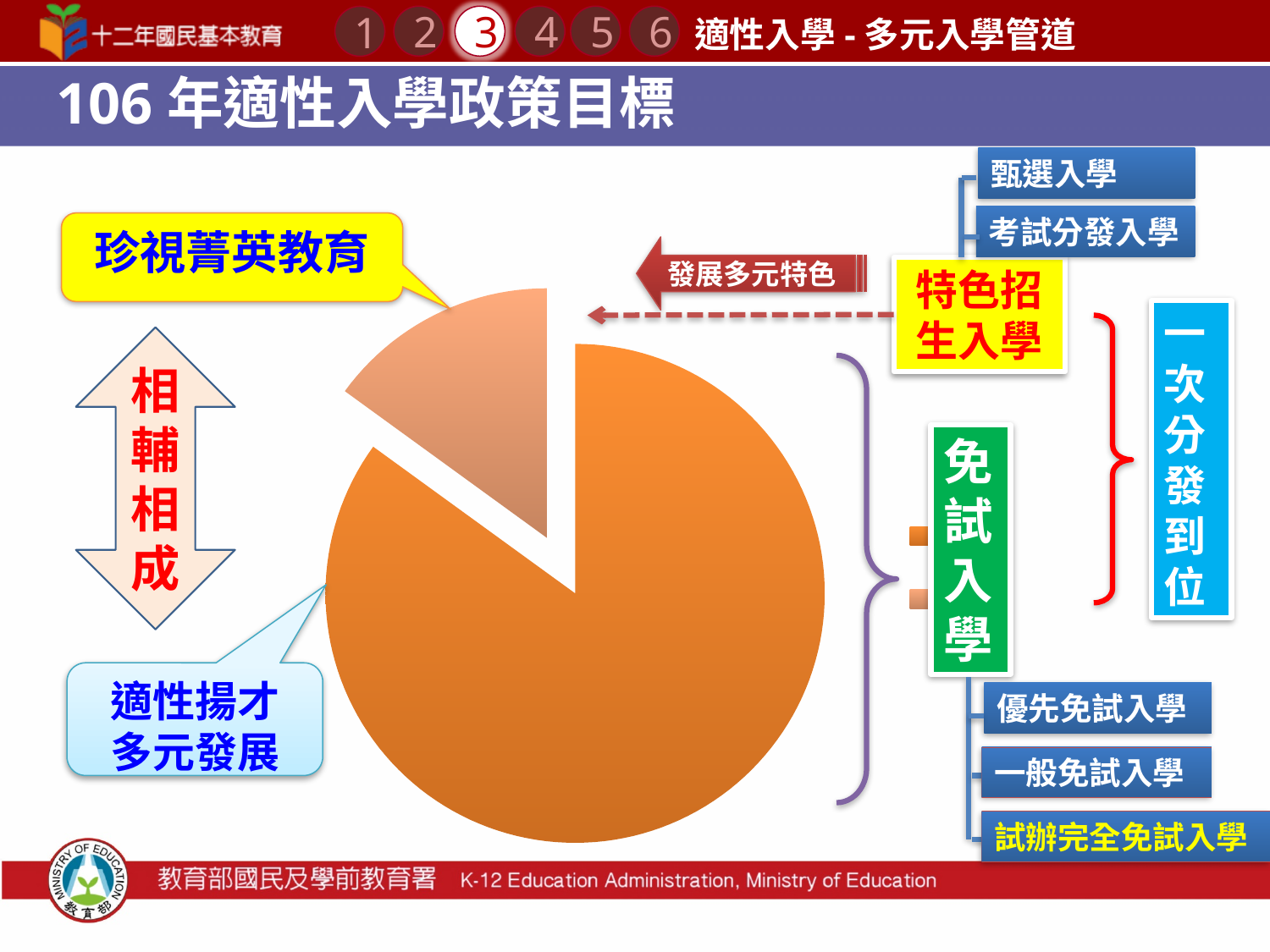
Which slice of the pie chart is the smallest? 特色招生入學 What kind of chart is shown on the slide? pie chart Which is larger in the pie chart, the 免試入學 slice or the 特色招生入學 slice? 免試入學 What label is attached to the large orange slice of the pie chart? 免試入學 Which slice of the pie chart is pulled out (exploded) from the rest of the pie? 特色招生入學 Is the 免試入學 slice more or less than half of the pie? more Which slice of the pie chart is the largest? 免試入學 How many slices does the pie chart have? 2